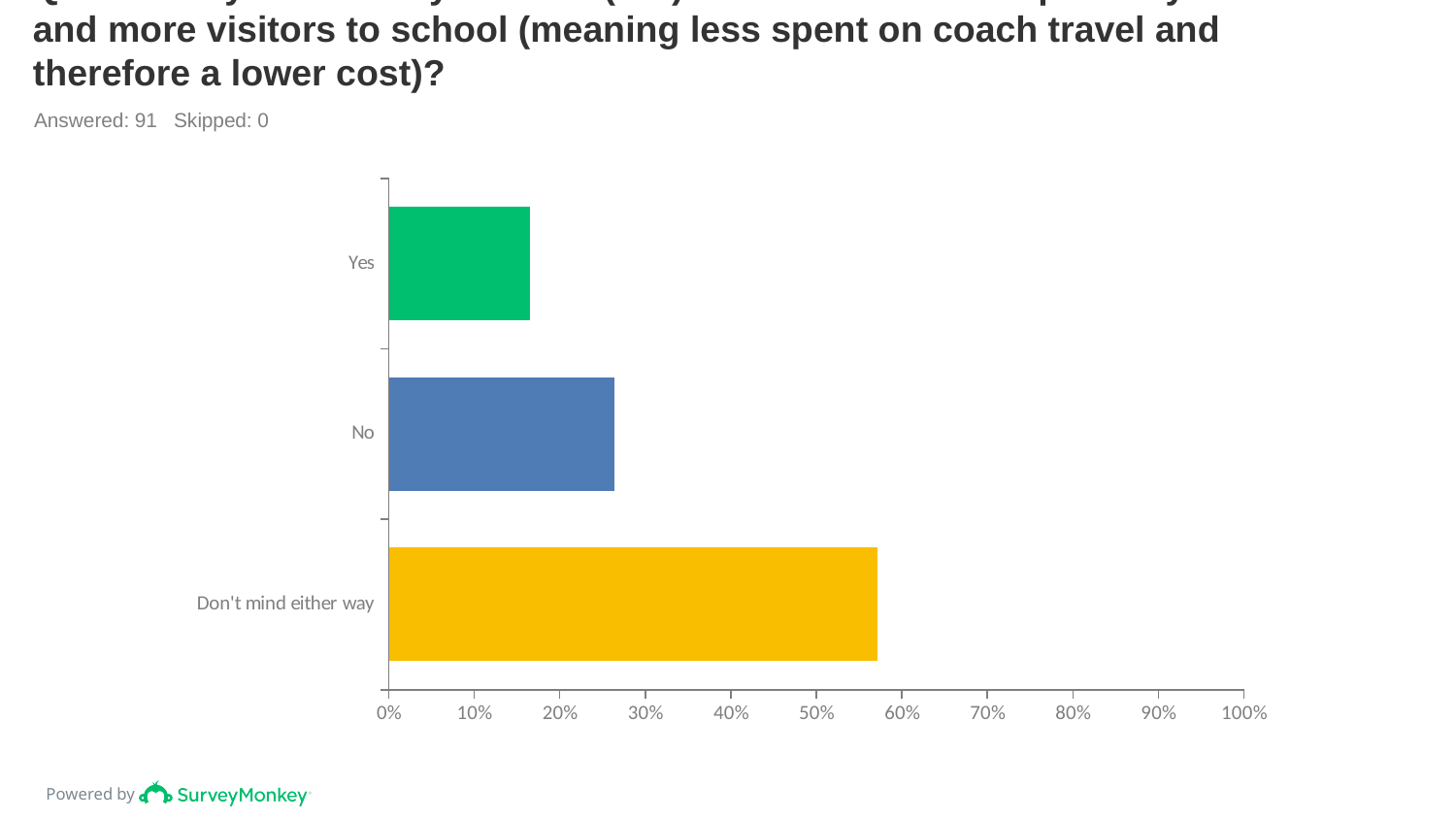
Which category has the lowest value? Yes Is the value for No greater or less than 20%? greater Is the value for Yes greater or less than 20%? less What kind of chart is shown on the slide? bar chart How many respondents answered the question according to the slide? 91 How many categories are plotted in the chart? 3 Is the value for Don't mind either way greater or less than 60%? less Which is larger, the value for Yes or the value for No? No Which category has the highest value? Don't mind either way